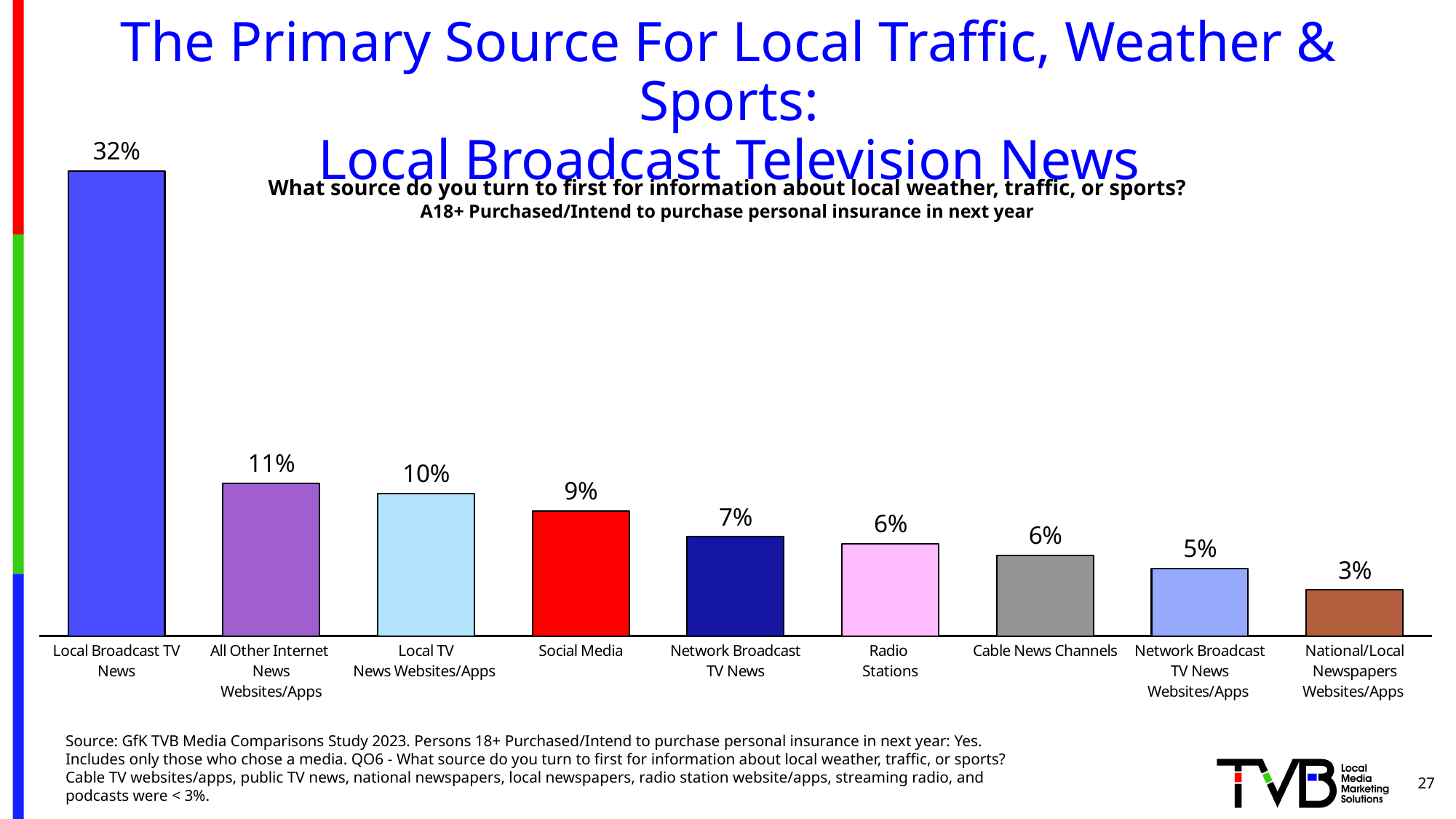
What is the difference between Radio Stations and National/Local Newspapers Websites/Apps? 3% Which source has the highest value? Local Broadcast TV News What is the difference between Local Broadcast TV News and All Other Internet News Websites/Apps? 21% How many sources are shown in the chart? 9 What is the value for Social Media? 9% What percentage is shown for Local Broadcast TV News? 32% What percentage is shown for Network Broadcast TV News Websites/Apps? 5% What kind of chart is this? Bar chart Which source has the lowest value? National/Local Newspapers Websites/Apps What colour is the bar for Social Media? Red Which is larger, Local TV News Websites/Apps or Network Broadcast TV News? Local TV News Websites/Apps Do the values rise or fall from left to right across the chart? Fall